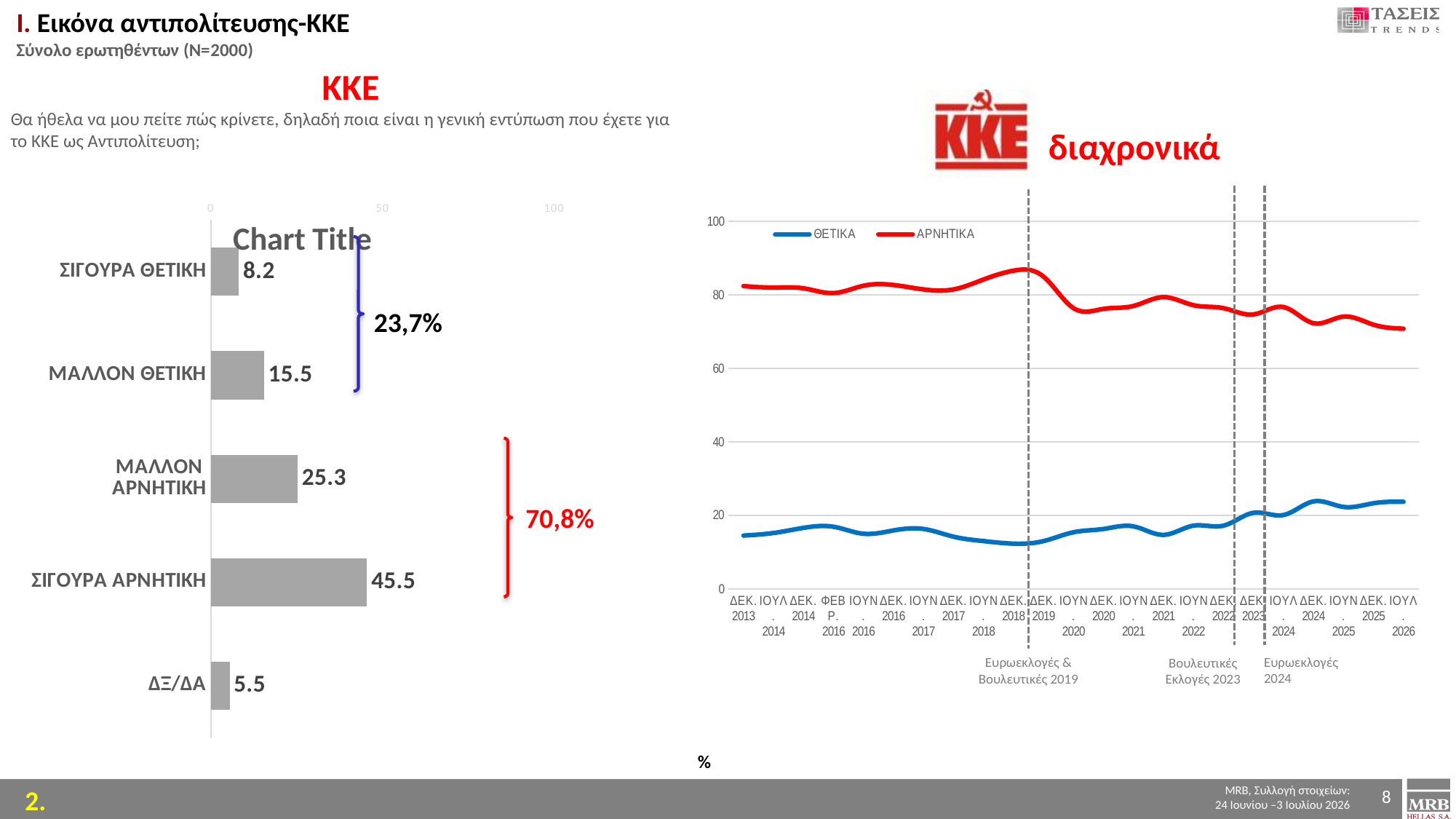
In the bar chart on the left, which is larger: ΣΙΓΟΥΡΑ ΘΕΤΙΚΗ or ΜΑΛΛΟΝ ΘΕΤΙΚΗ? ΜΑΛΛΟΝ ΘΕΤΙΚΗ In the bar chart on the left, what is the difference between ΣΙΓΟΥΡΑ ΑΡΝΗΤΙΚΗ and ΜΑΛΛΟΝ ΑΡΝΗΤΙΚΗ? 20.2 In the line chart on the right, is the value for ΑΡΝΗΤΙΚΑ at ΔΕΚ. 2018 greater or less than 80? greater In the bar chart on the left, what is the value for ΜΑΛΛΟΝ ΘΕΤΙΚΗ? 15.5 In the line chart on the right, does the ΘΕΤΙΚΑ series rise or fall overall from ΔΕΚ. 2013 to ΙΟΥΛ. 2026? rise In the bar chart on the left, what is the value for ΔΞ/ΔΑ? 5.5 What kind of chart is the chart on the left of the slide? bar chart How many series does the legend of the line chart on the right list? 2 In the bar chart on the left, which category has the highest value? ΣΙΓΟΥΡΑ ΑΡΝΗΤΙΚΗ In the bar chart on the left, which category has the lowest value? ΔΞ/ΔΑ In the bar chart on the left, what is the value for ΣΙΓΟΥΡΑ ΑΡΝΗΤΙΚΗ? 45.5 How many categories does the bar chart on the left show? 5